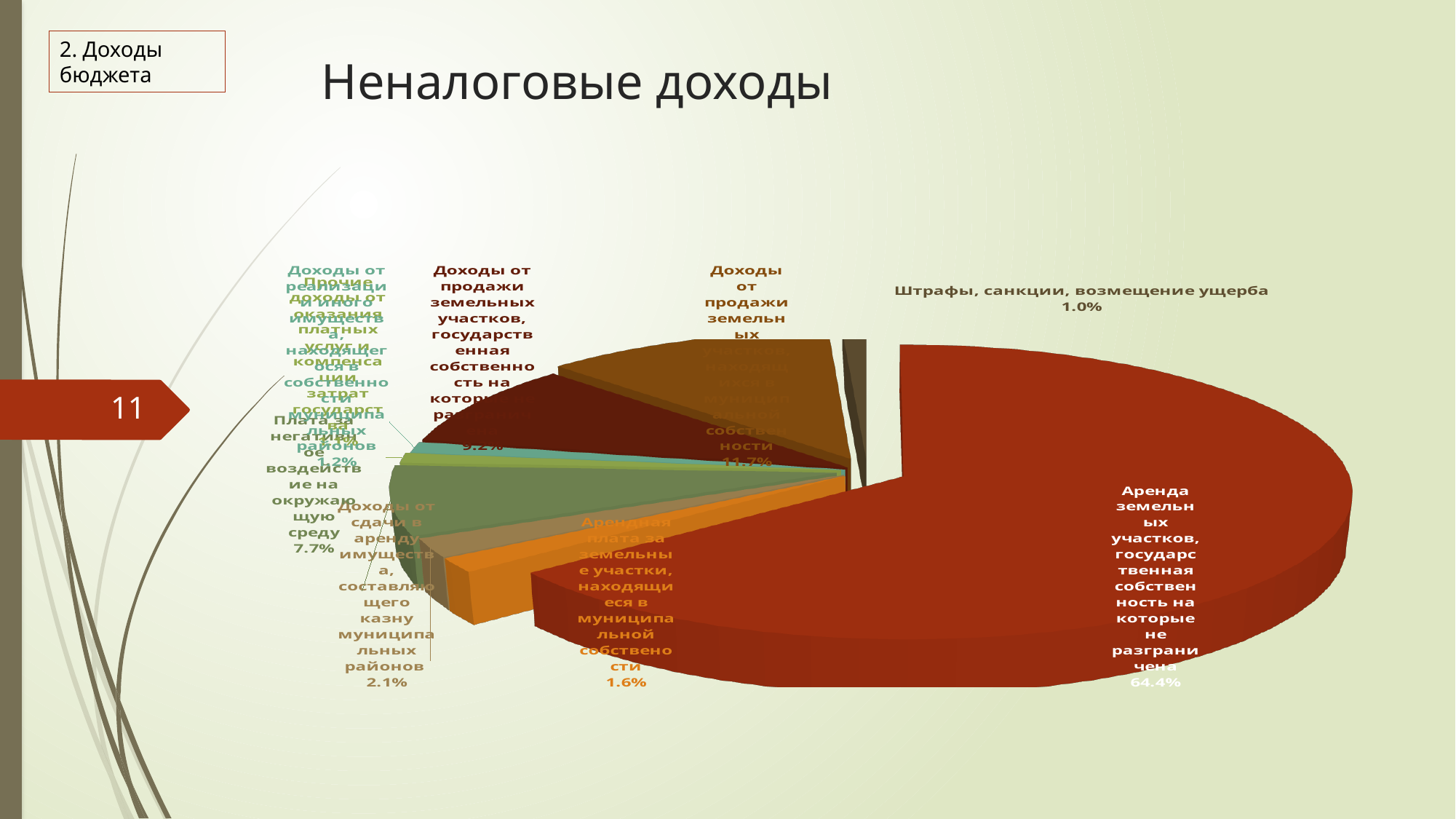
What is the value shown for 'Доходы от сдачи в аренду имущества, составляющего казну муниципальных районов'? 2.1% What is the title of the chart on the slide? Неналоговые доходы What is the value shown for 'Плата за негативное воздействие на окружающую среду'? 7.7% What share of the pie is 'Аренда земельных участков, государственная собственность на которые не разграничена'? 64.4% What is the value shown for 'Штрафы, санкции, возмещение ущерба'? 1.0% What is the value shown for 'Арендная плата за земельные участки, находящиеся в муниципальной собственности'? 1.6% What is the difference between the share for 'Плата за негативное воздействие на окружающую среду' and 'Доходы от сдачи в аренду имущества, составляющего казну муниципальных районов'? 5.6% What is the value shown for 'Доходы от продажи земельных участков, находящихся в муниципальной собственности'? 11.7% Which is larger: 'Доходы от продажи земельных участков, находящихся в муниципальной собственности' or 'Плата за негативное воздействие на окружающую среду'? Доходы от продажи земельных участков, находящихся в муниципальной собственности Which category has the largest share of the pie? Аренда земельных участков, государственная собственность на которые не разграничена What kind of chart is shown on the slide? pie chart What is the difference between the share for 'Аренда земельных участков, государственная собственность на которые не разграничена' and 'Доходы от продажи земельных участков, находящихся в муниципальной собственности'? 52.7%